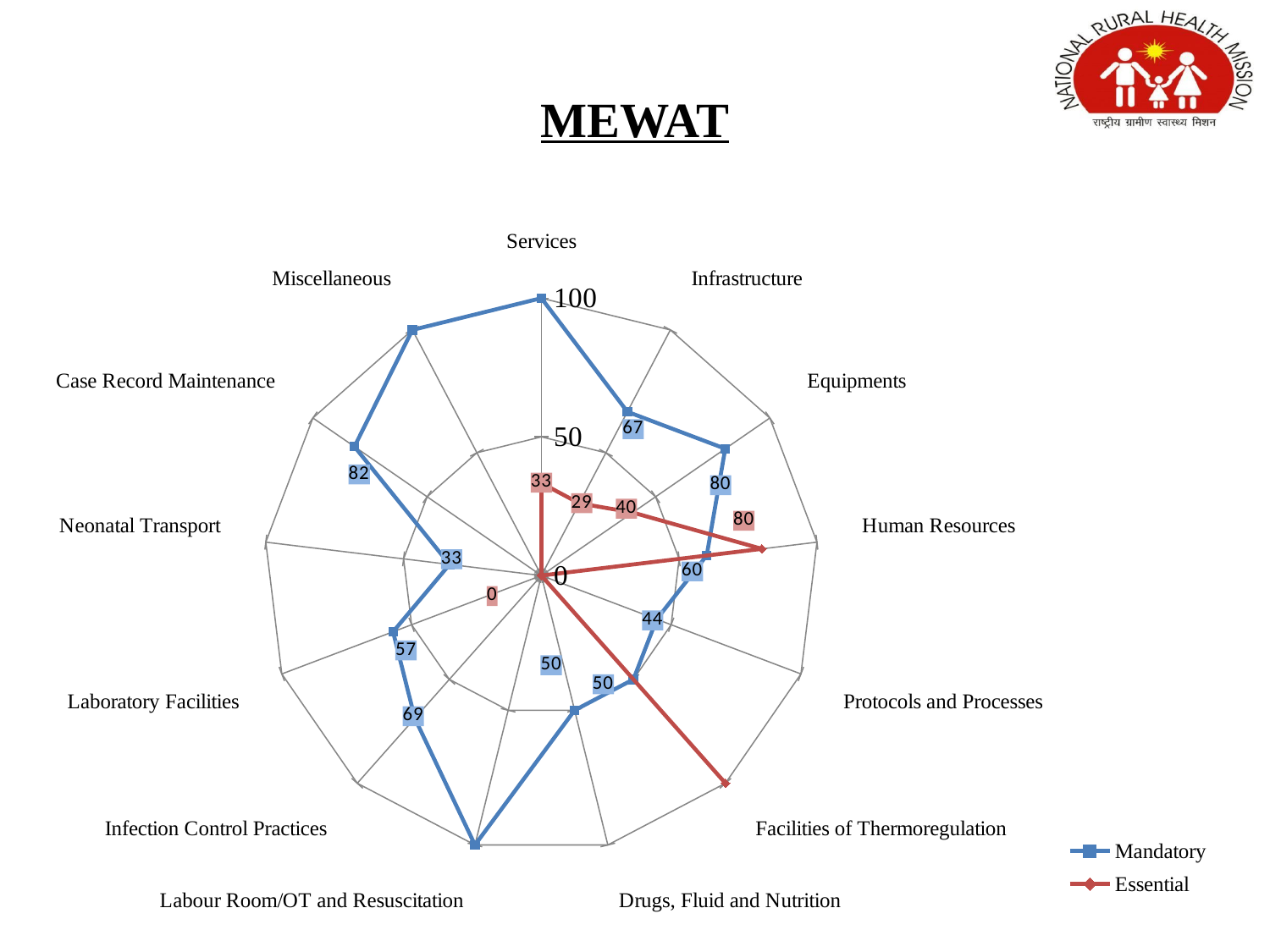
What is the Essential value for Infrastructure? 29 Which series is drawn in red on the chart? Essential How many series does the legend list? 2 What kind of chart is shown on the slide? Radar chart Is the Mandatory value for Services greater or less than 50? greater How many categories are plotted around the radar chart? 13 What is the difference between the Mandatory and Essential values for Equipments? 40 Which is larger for Human Resources, the Mandatory value or the Essential value? Essential What is the Essential value for Human Resources? 80 What is the Mandatory value for Protocols and Processes? 44 What is the Mandatory value for Case Record Maintenance? 82 What is the Mandatory value for Equipments? 80